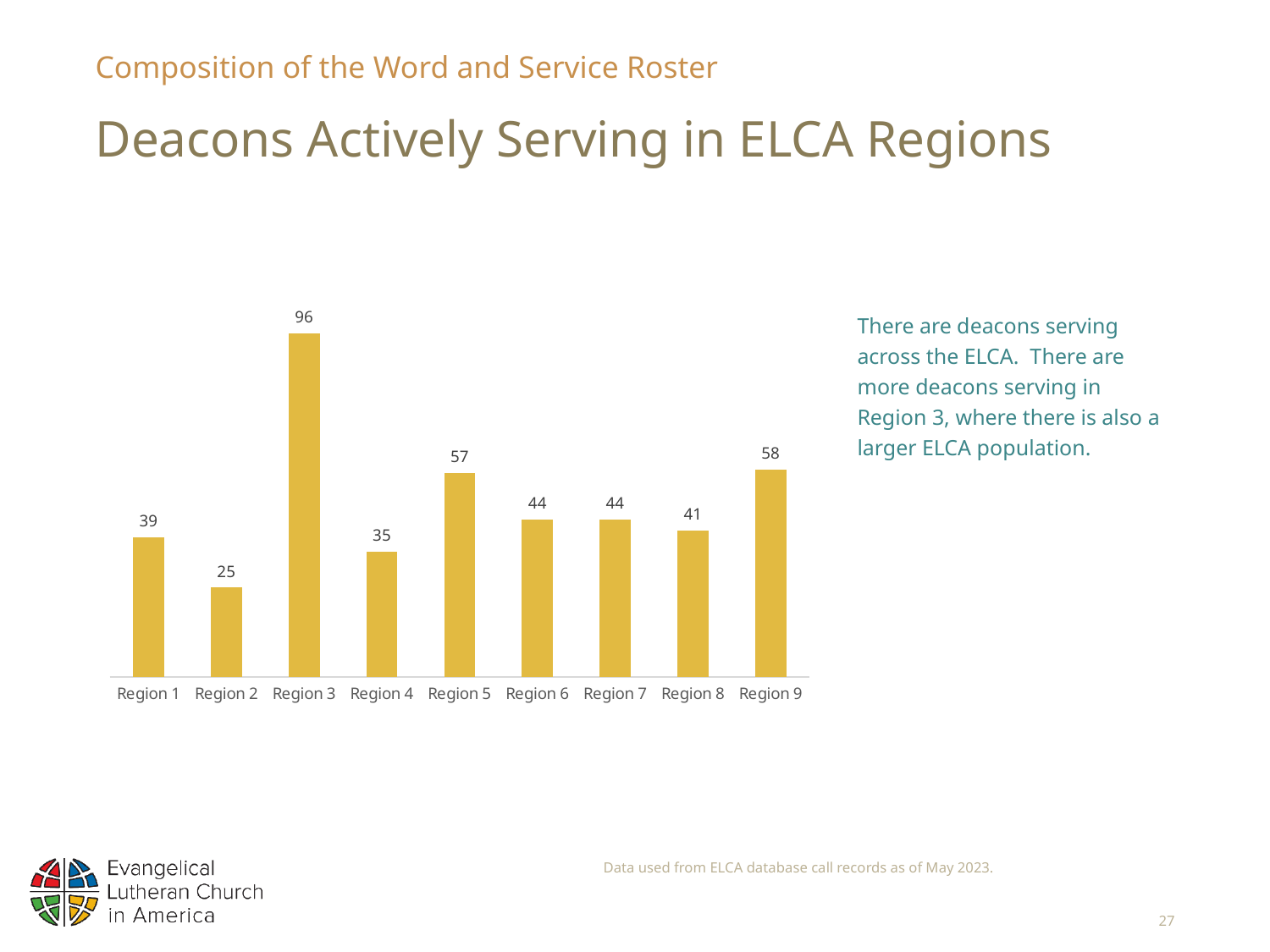
Which region has the lowest number of deacons actively serving? Region 2 Which has a larger value, Region 4 or Region 5? Region 5 How many deacons are actively serving in Region 3? 96 What is the value shown for Region 8? 41 What is the title of the chart on the slide? Deacons Actively Serving in ELCA Regions What kind of chart is shown on the slide? Bar chart Which has a larger value, Region 9 or Region 1? Region 9 What is the difference between the values for Region 1 and Region 2? 14 How many regions are shown on the chart? 9 What is the value shown for Region 5? 57 What is the difference between the values for Region 3 and Region 9? 38 Which region has the highest number of deacons actively serving? Region 3